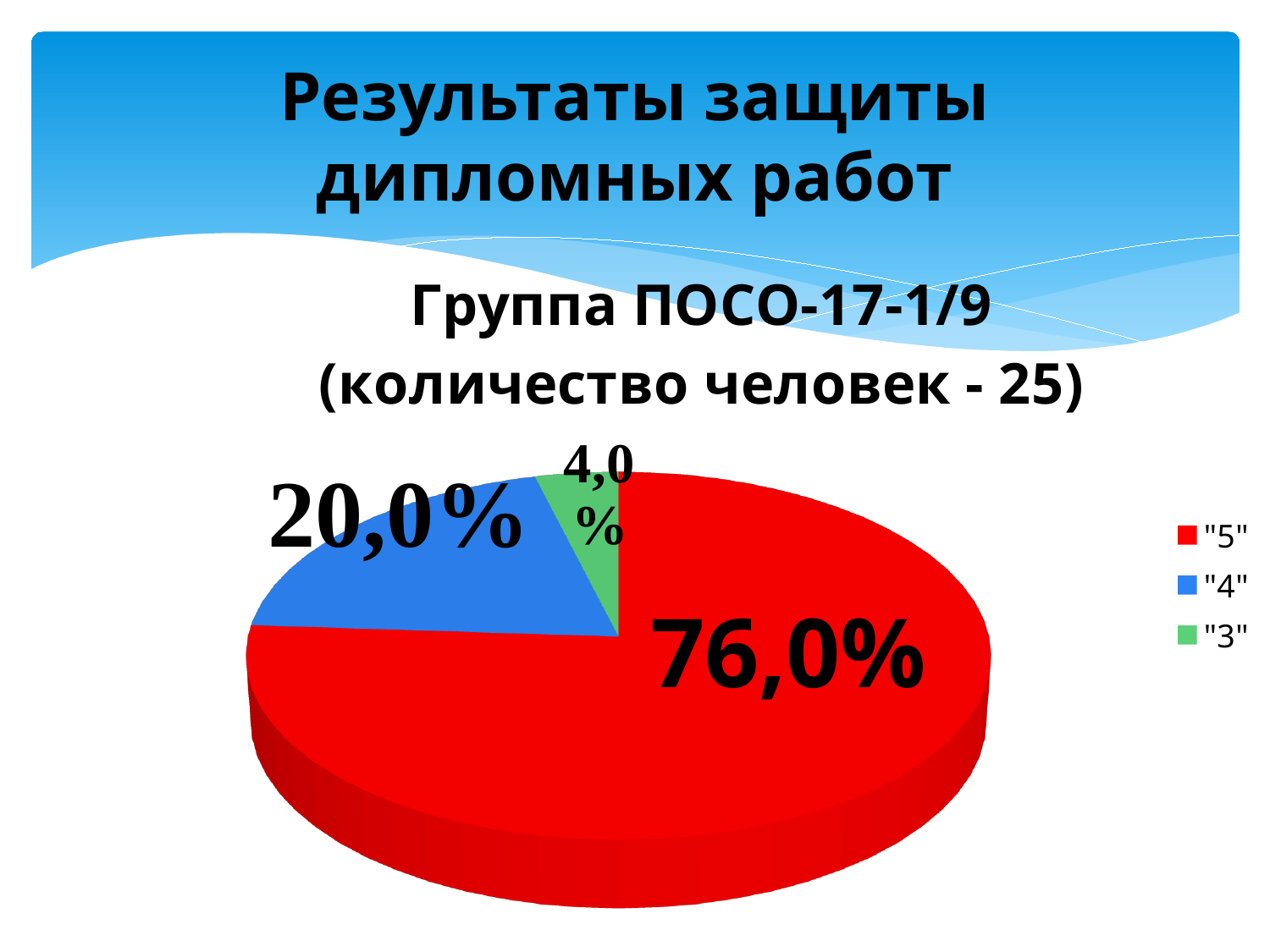
What is the title of the chart? Группа ПОСО-17-1/9 (количество человек - 25) What share of the pie does the "3" slice take? 4,0% What is the difference in percentage points between the "5" slice and the "4" slice? 56,0% How many entries does the legend list? 3 What share of the pie does the "4" slice take? 20,0% How many slices does the pie chart have? 3 What colour is the "4" slice in the pie chart? Blue Which slice is larger, "4" or "3"? "4" What kind of chart is shown on the slide? Pie chart Which grade has the largest slice of the pie? "5" What share of the pie does the "5" slice take? 76,0% Which grade has the smallest slice of the pie? "3"